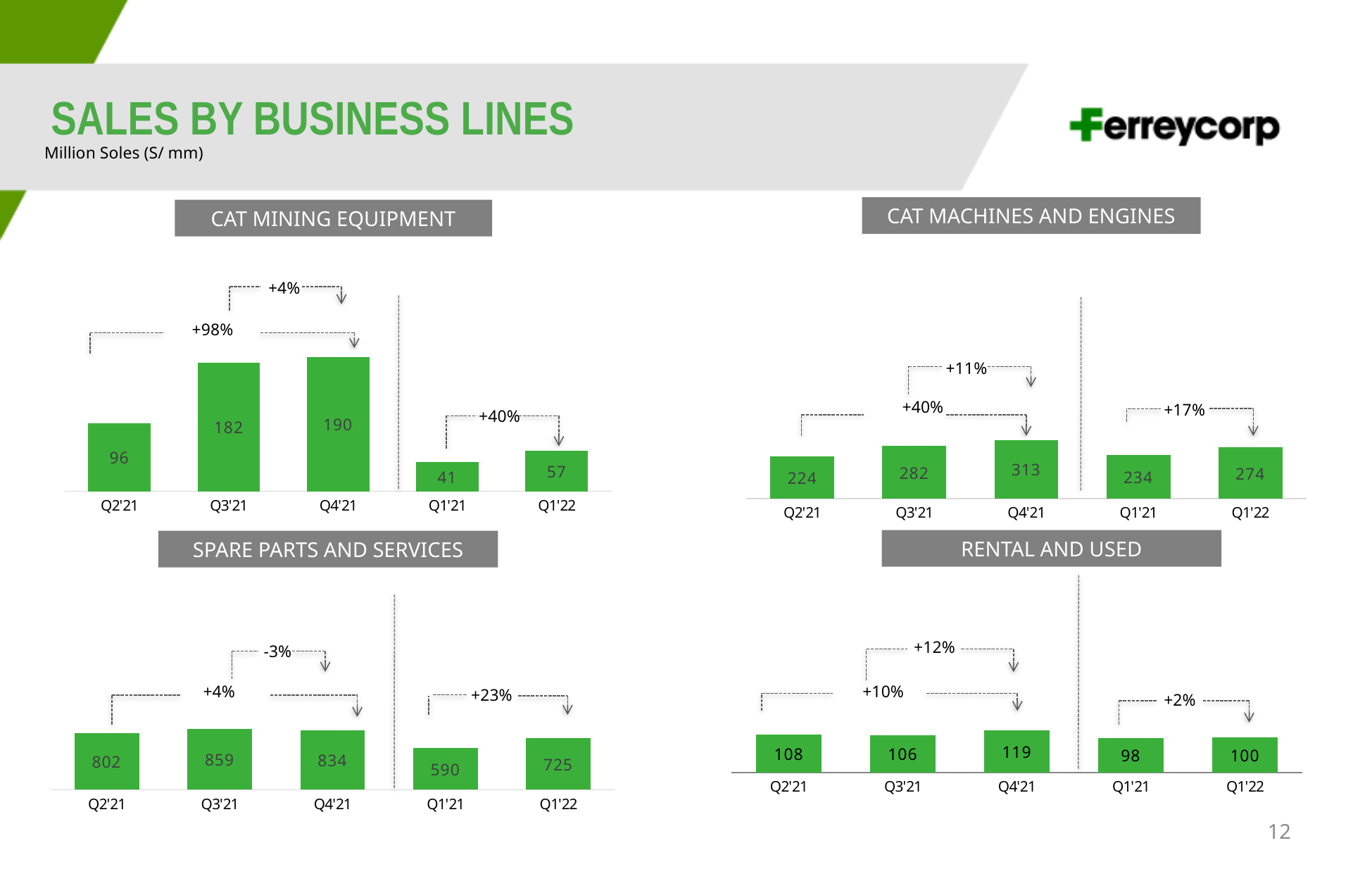
In the RENTAL AND USED chart, what is the value for Q4'21? 119 In the RENTAL AND USED chart, which quarter has the lowest value? Q1'21 In the SPARE PARTS AND SERVICES chart, which is larger, Q3'21 or Q4'21? Q3'21 In the CAT MINING EQUIPMENT chart, what is the value for Q3'21? 182 How many bars are shown in the RENTAL AND USED chart? 5 In the CAT MACHINES AND ENGINES chart, which quarter has the highest value? Q4'21 In the CAT MACHINES AND ENGINES chart, what is the difference between Q4'21 and Q2'21? 89 In the CAT MINING EQUIPMENT chart, which quarter has the lowest value? Q1'21 In the SPARE PARTS AND SERVICES chart, what is the value for Q1'21? 590 What type of chart is used for CAT MINING EQUIPMENT? Bar chart In the CAT MACHINES AND ENGINES chart, what is the value for Q1'22? 274 In the SPARE PARTS AND SERVICES chart, what is the difference between Q1'22 and Q1'21? 135